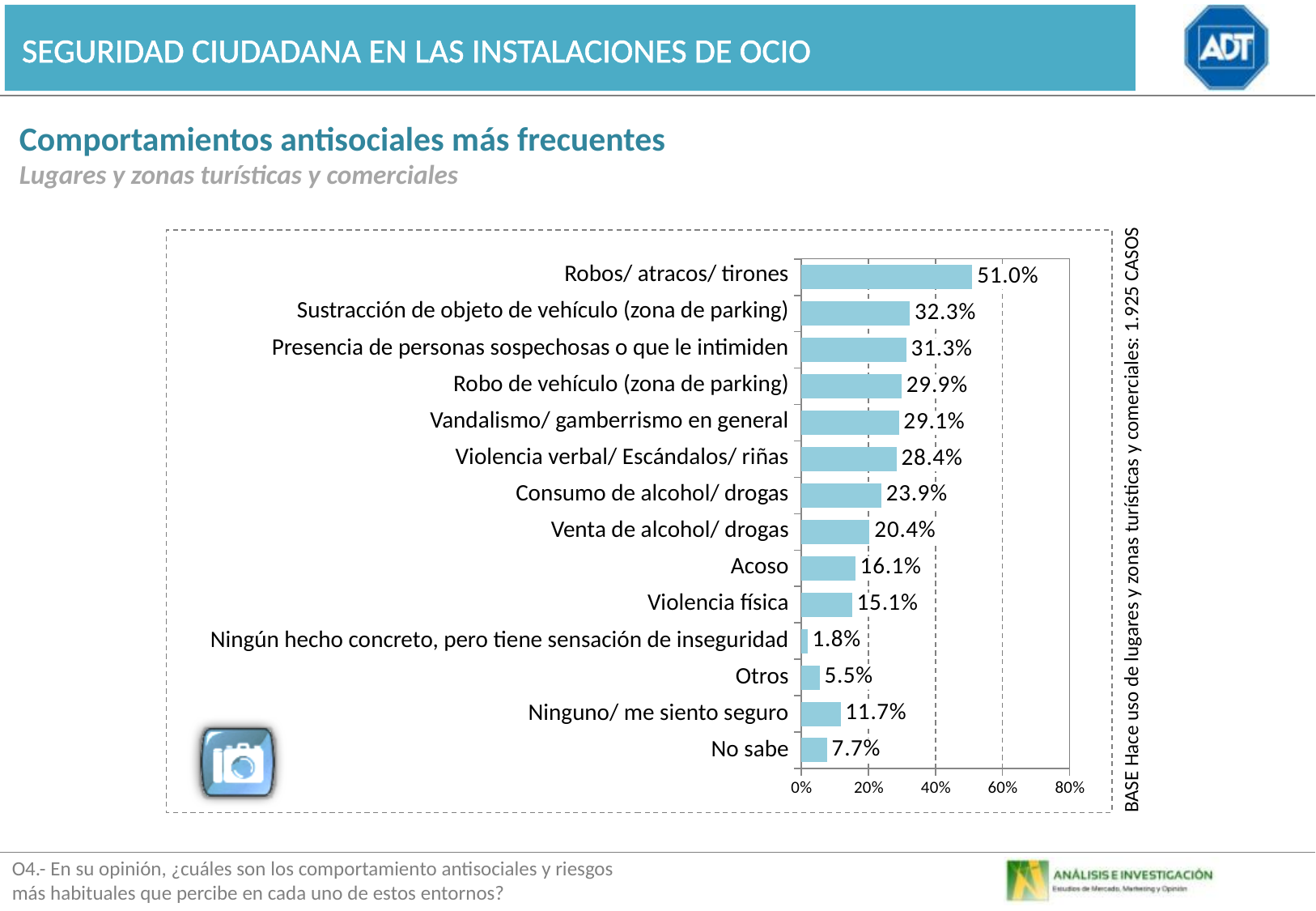
What is the value for Robos/ atracos/ tirones? 51.0% Which category has the highest value? Robos/ atracos/ tirones Is the value for Venta de alcohol/ drogas greater or less than 40%? less What is the value for Consumo de alcohol/ drogas? 23.9% Which category has the lowest value? Ningún hecho concreto, pero tiene sensación de inseguridad How many categories are shown in the chart? 14 What is the subtitle shown under the chart heading 'Comportamientos antisociales más frecuentes'? Lugares y zonas turísticas y comerciales What is the value for Ninguno/ me siento seguro? 11.7% What kind of chart is shown on the slide? bar chart Which is larger, Acoso or Violencia física? Acoso What is the value for No sabe? 7.7% What is the difference between Robos/ atracos/ tirones and Sustracción de objeto de vehículo (zona de parking)? 18.7%